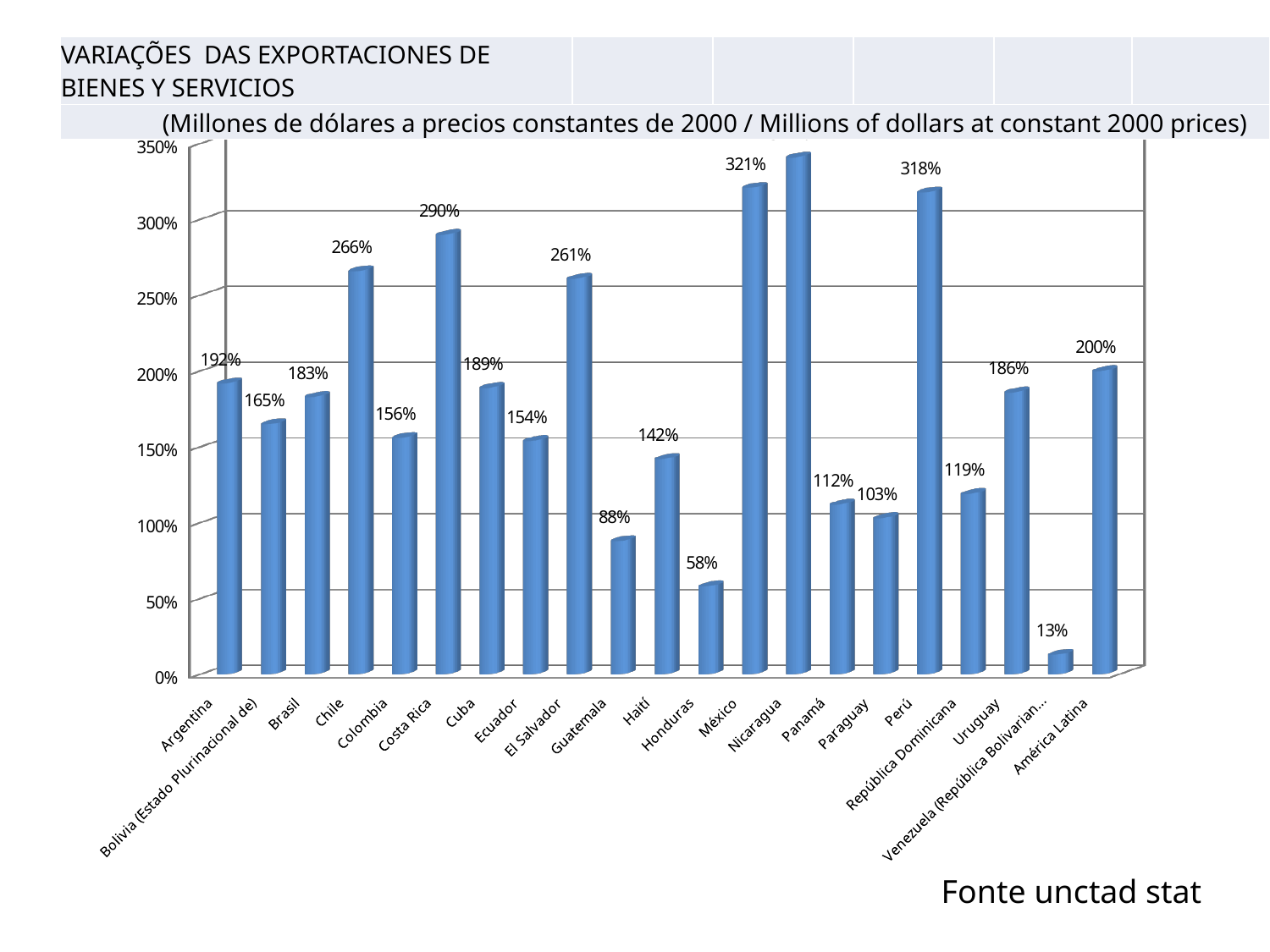
What is the value shown for República Dominicana? 119% Which is larger, the value for México or the value for Perú? México What is the difference between the values for Costa Rica and Chile? 24 percentage points What is the value shown for Honduras? 58% What is the value shown for Costa Rica? 290% Which category has the lowest value? Venezuela (República Bolivariana...) How many categories are shown on the x axis? 21 What source is cited below the chart? Fonte unctad stat Which category has the tallest bar? Nicaragua Is the value for Nicaragua greater or less than 300%? greater What is the value shown for América Latina? 200% What kind of chart is shown on the slide? Bar chart